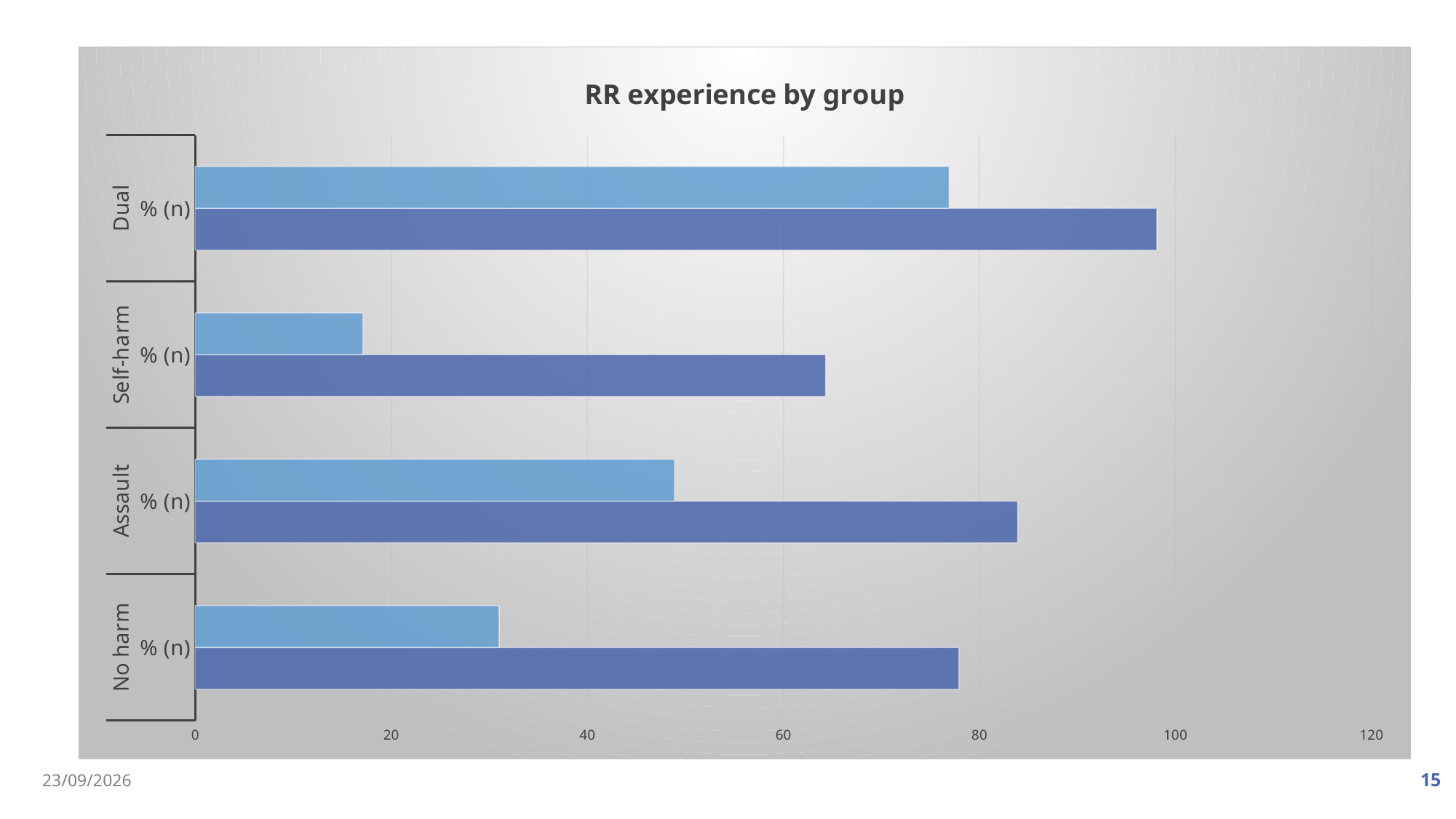
What kind of chart is shown on the slide? bar chart Which group has the shortest dark blue bar? Self-harm Which is longer, the light blue bar for Dual or the light blue bar for Assault? the light blue bar for Dual Is the light blue bar for No harm greater or less than 40? less For the Assault group, which bar is longer, the light blue bar or the dark blue bar? the dark blue bar Is the light blue bar for Self-harm greater or less than 20? less Which group has the longest dark blue bar? Dual Which group has the shortest light blue bar? Self-harm How many groups are shown on the vertical axis of the chart? 4 What is the title of the chart? RR experience by group Is the dark blue bar for Dual greater or less than 80? greater